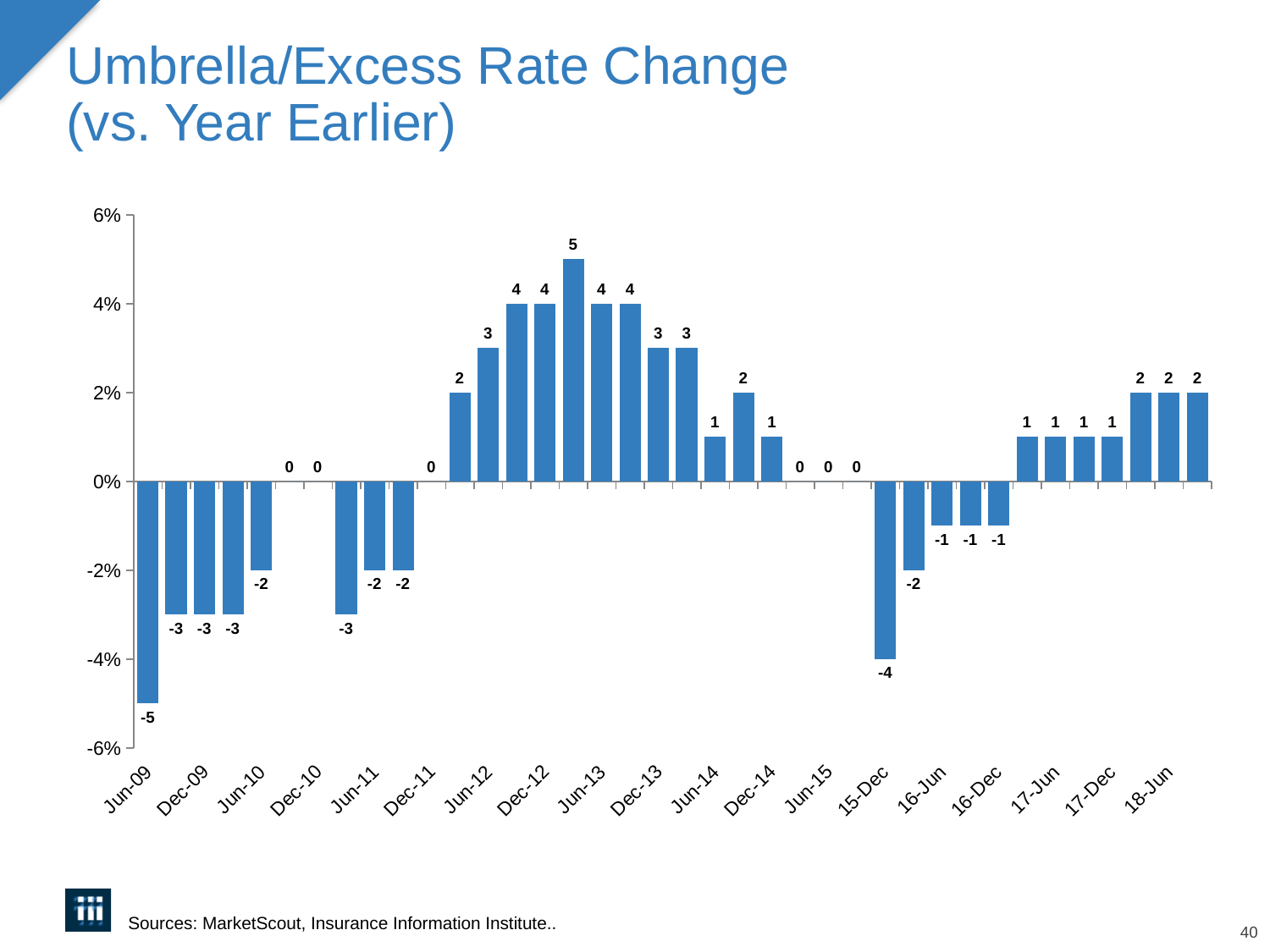
What is the title of the chart? Umbrella/Excess Rate Change (vs. Year Earlier) What type of chart is shown on the slide? Bar chart What is the value for 15-Dec? -4 What is the value for Dec-12? 4 What is the value for 18-Jun? 2 What is the lowest value shown in the chart? -5 What is the value for Jun-09? -5 Do the values rise or fall from Jun-09 to Jun-12? Rise What is the highest value shown in the chart? 5 Which is lower, the value for Jun-09 or the value for 15-Dec? Jun-09 What is the difference between the highest and lowest values in the chart? 10 Is the highest bar in the chart greater or less than 4%? greater